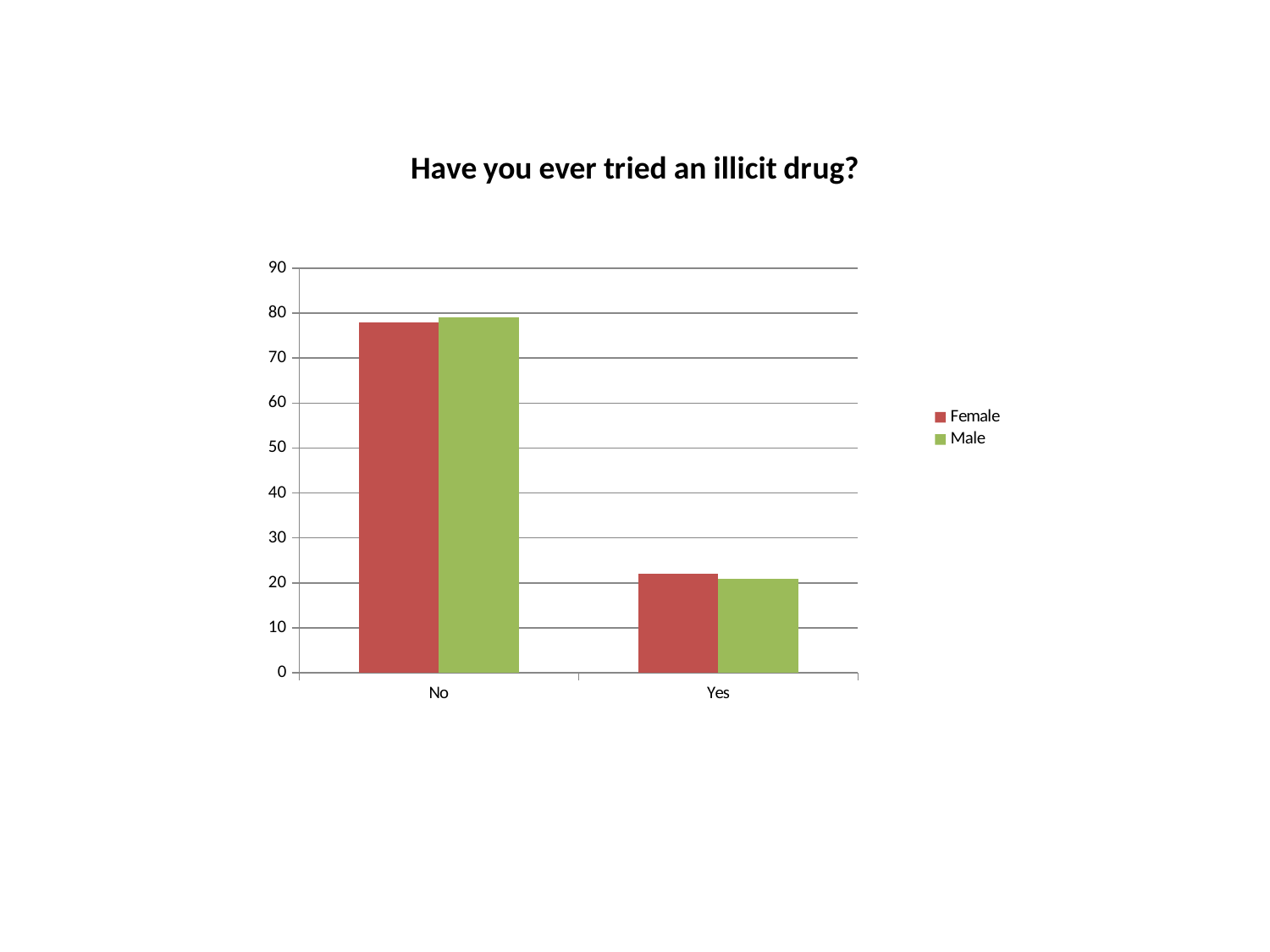
What kind of chart is shown on the slide? bar chart Is the Female value for Yes greater or less than 30? less For the Male series, which category has the lowest value? Yes Which series is shown in green? Male What is the title of the chart? Have you ever tried an illicit drug? How many categories are shown on the x axis? 2 Is the Male value for Yes greater or less than 30? less For the Female series, which category has the highest value? No For the Female series, is the value for No larger or the value for Yes? No Is the Female value for No greater or less than 70? greater How many series does the legend list? 2